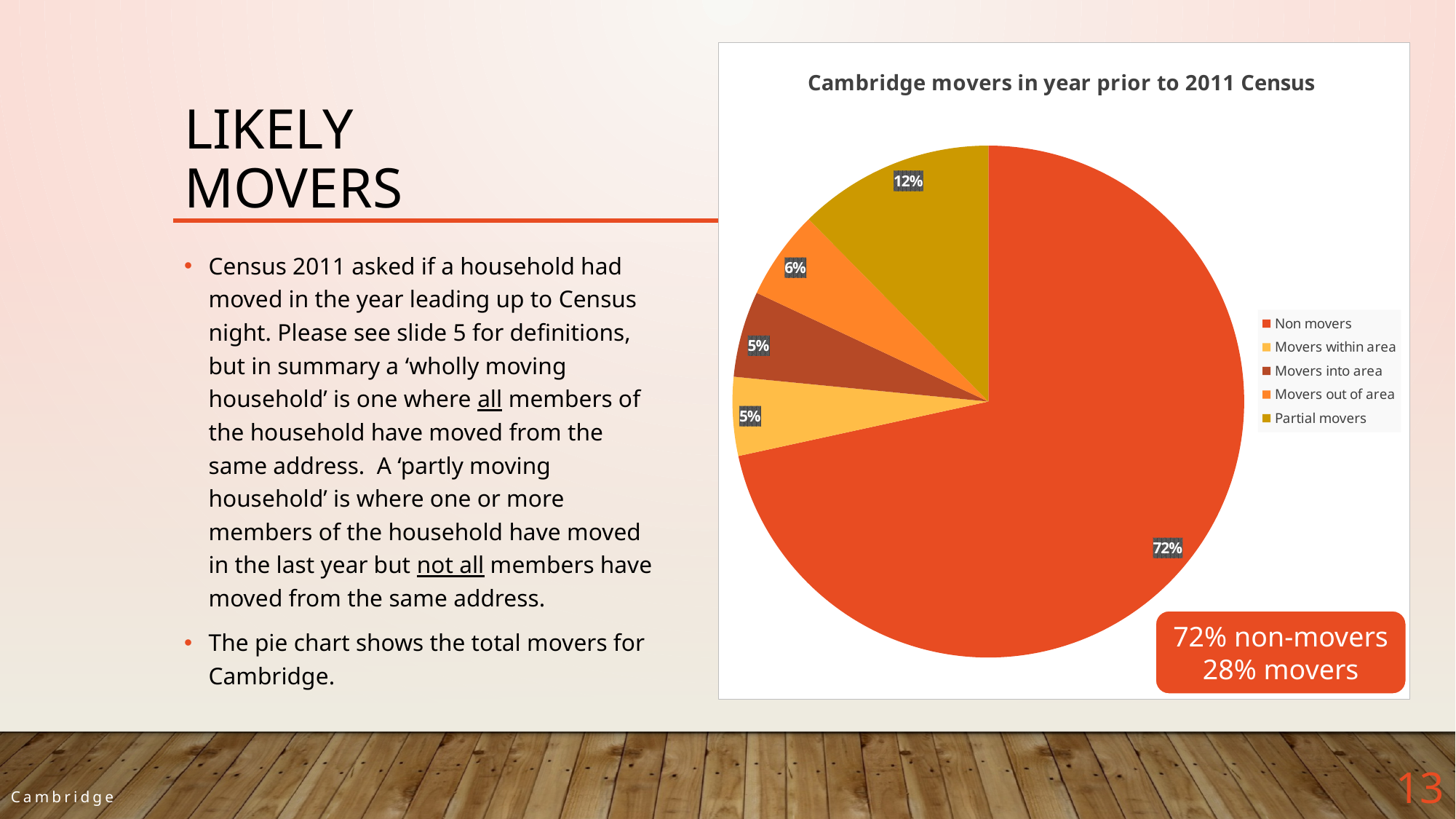
What is the combined share of Movers out of area and Partial movers? 18% What type of chart is shown on the slide? pie chart Which is larger, Partial movers or Movers out of area? Partial movers What is the difference in percentage points between Non movers and Partial movers? 60 What percentage of the pie is Movers into area? 5% What percentage of the pie is Movers within area? 5% What is the title of the chart? Cambridge movers in year prior to 2011 Census What percentage of the pie is Non movers? 72% How many categories does the legend list? 5 Which category has the largest slice of the pie? Non movers What percentage of the pie is Movers out of area? 6% What percentage of the pie is Partial movers? 12%